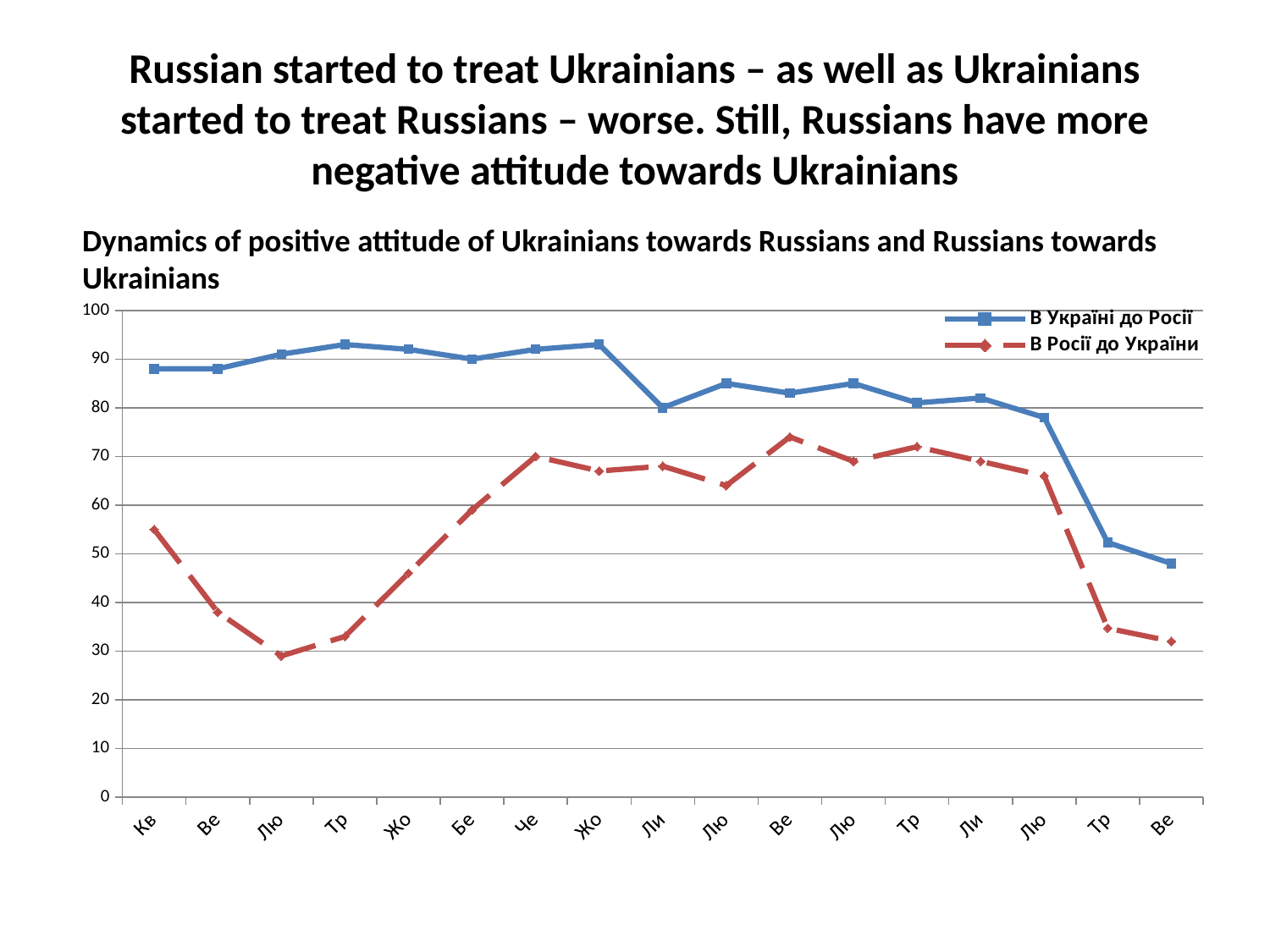
At the first point on the x axis, which series has the higher value: 'В Україні до Росії' or 'В Росії до України'? В Україні до Росії What is the title of the chart? Dynamics of positive attitude of Ukrainians towards Russians and Russians towards Ukrainians Which series is drawn as a dashed red line? В Росії до України Does the 'В Україні до Росії' series end higher or lower than it starts? lower What kind of chart is shown on the slide? line chart Is the last value of the 'В Україні до Росії' series greater or less than 50? less Is the first value of the 'В Україні до Росії' series greater or less than 80? greater How many series does the legend list? 2 How many data points does each line have along the x axis? 17 Is the last value of the 'В Росії до України' series greater or less than 40? less